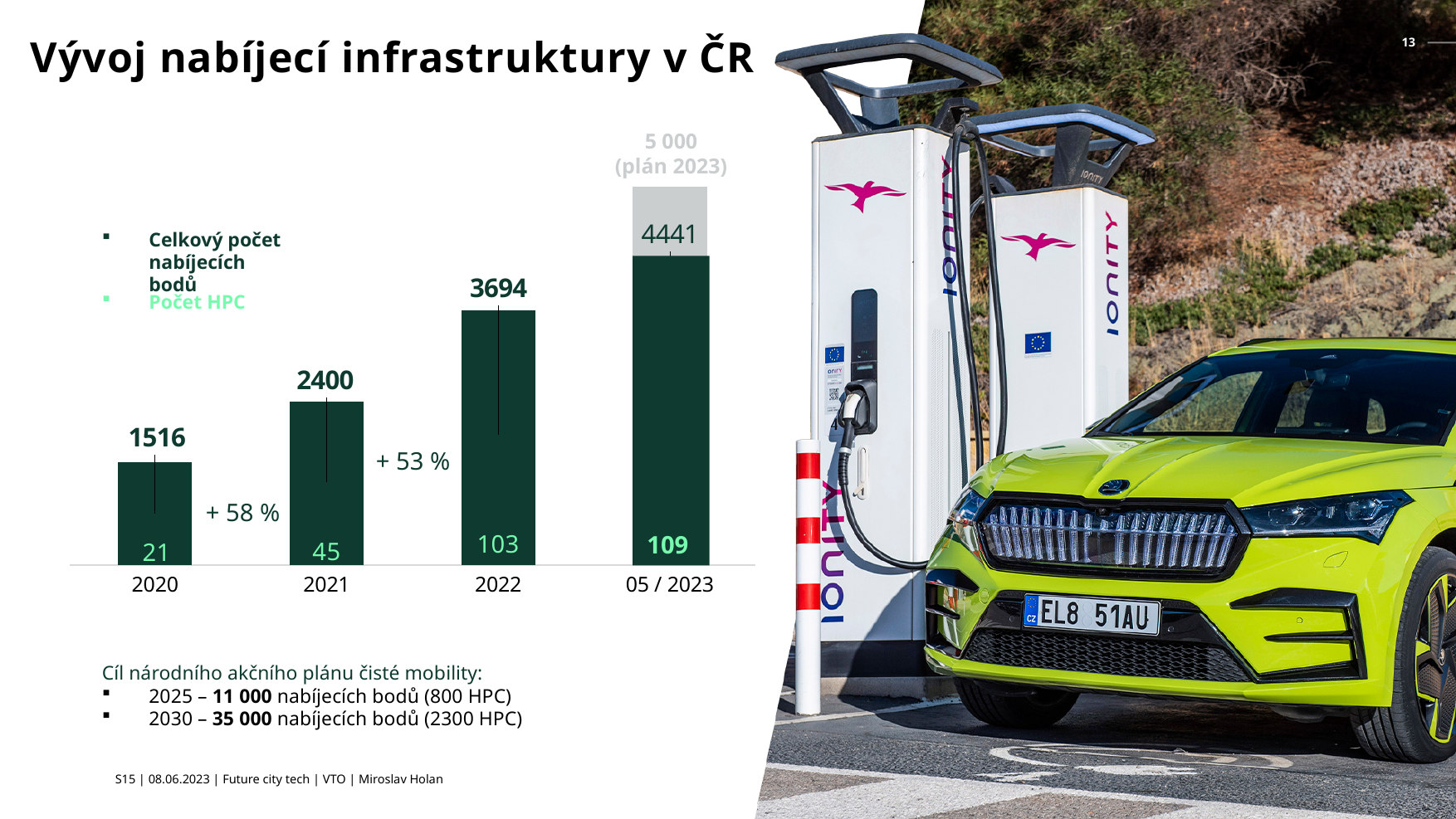
Which is larger: the total number of charging points in 2021 or in 2020? 2021 How many HPC (Počet HPC) are shown for 2022? 103 Which category has the highest total number of charging points? 05 / 2023 What planned value for 2023 is shown above the last bar? 5 000 (plán 2023) What is the difference between the total number of charging points in 2022 and in 2021? 1294 How many HPC are shown for 2020? 21 How many time periods are shown on the x axis of the chart? 4 What is the total number of charging points shown for 05 / 2023? 4441 What is the difference in the number of HPC between 05 / 2023 and 2022? 6 What is the total number of charging points (Celkový počet nabíjecích bodů) shown for 2021? 2400 What type of chart is used on the slide? bar chart Which year has the lowest total number of charging points? 2020